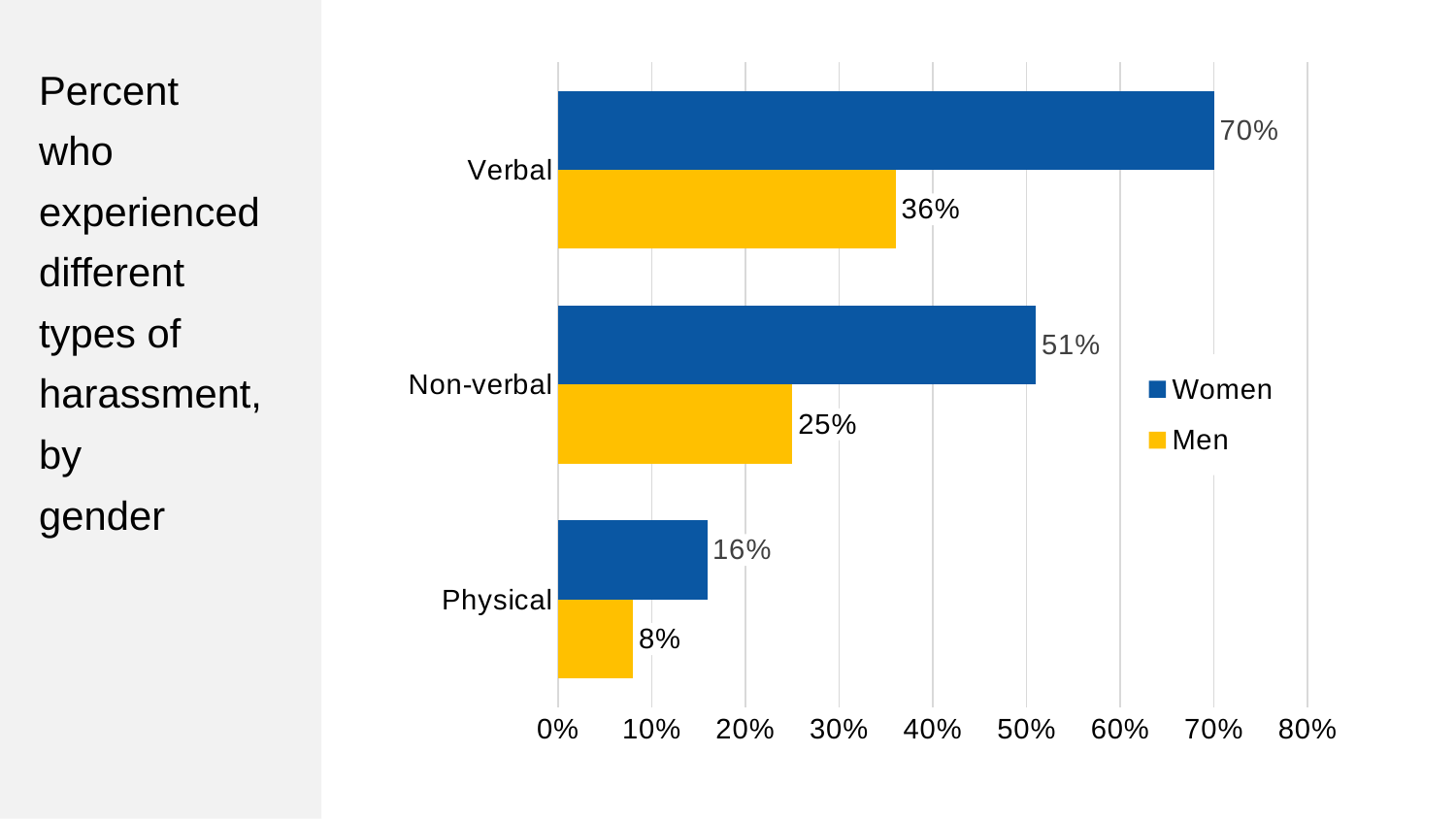
Which type of harassment has the highest value for women? Verbal What is the difference between the women's and men's values for verbal harassment? 34% Which is larger: the women's value for non-verbal harassment or the men's value for verbal harassment? Women's value for non-verbal harassment What percent of men experienced non-verbal harassment? 25% What percent of women experienced verbal harassment? 70% How many types of harassment are shown on the chart? 3 What kind of chart is shown on the slide? Bar chart Which type of harassment has the lowest value for men? Physical What is the difference between the women's and men's values for physical harassment? 8% What percent of men experienced physical harassment? 8% Which colour represents Men in the chart? Yellow How many series does the legend list? 2